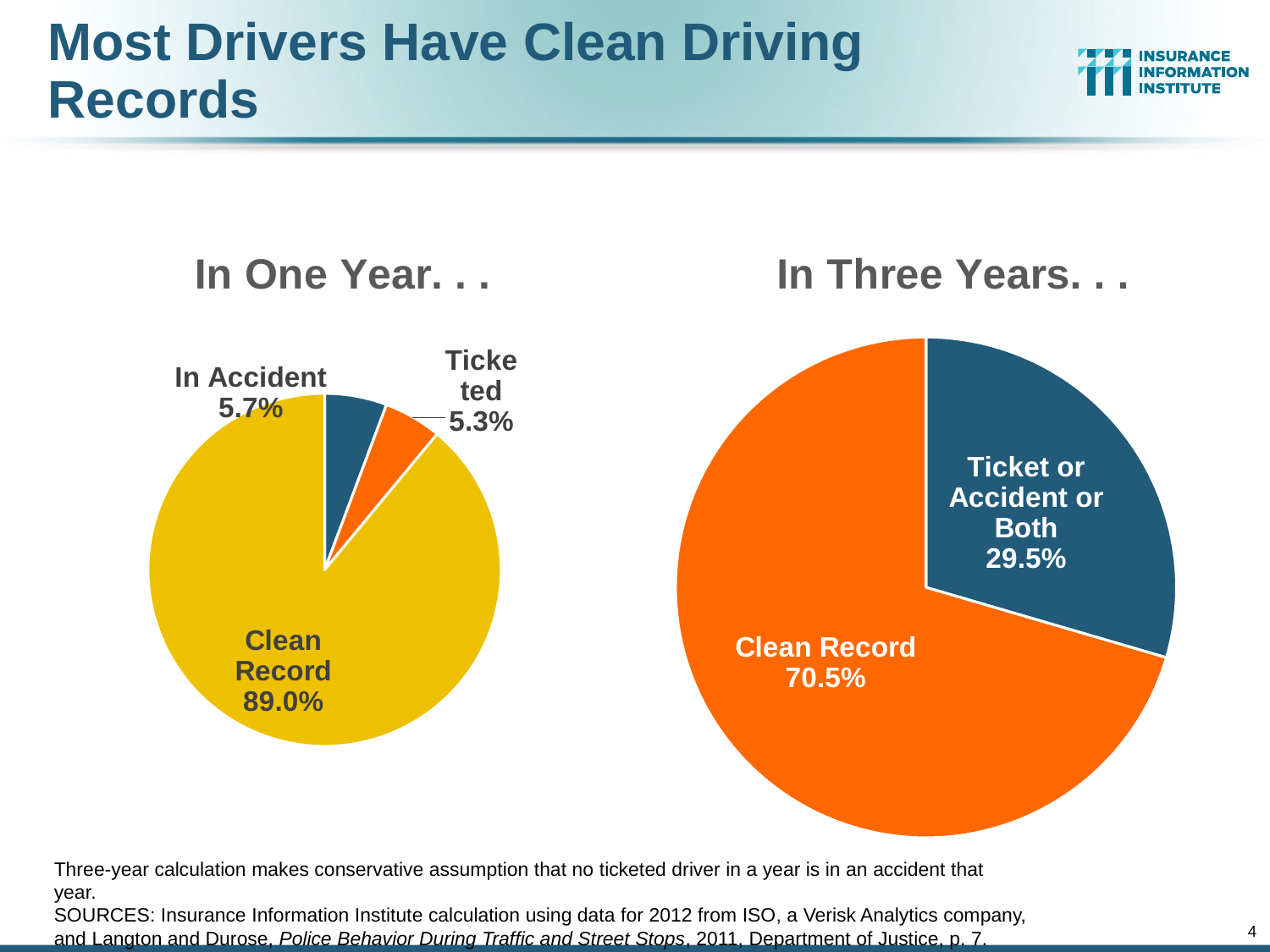
In the "In One Year. . ." chart, which category has the largest slice? Clean Record In the "In Three Years. . ." chart, what share of drivers have a Clean Record? 70.5% In the "In One Year. . ." chart, which category has the smallest slice? Ticketed Which is larger: the Clean Record share in the "In One Year. . ." chart or the Clean Record share in the "In Three Years. . ." chart? In One Year. . . In the "In Three Years. . ." chart, what percentage of drivers had a Ticket or Accident or Both? 29.5% In the "In One Year. . ." chart, what is the difference between the Clean Record share and the In Accident share? 83.3 percentage points In the "In One Year. . ." chart, what percentage of drivers were Ticketed? 5.3% How many slices does the "In One Year. . ." pie chart have? 3 In the "In One Year. . ." chart, what percentage of drivers were In Accident? 5.7% In the "In One Year. . ." chart, what share of drivers have a Clean Record? 89.0% What type of chart is used for "In Three Years. . ."? Pie chart In the "In Three Years. . ." chart, what is the difference between the Clean Record share and the Ticket or Accident or Both share? 41.0 percentage points